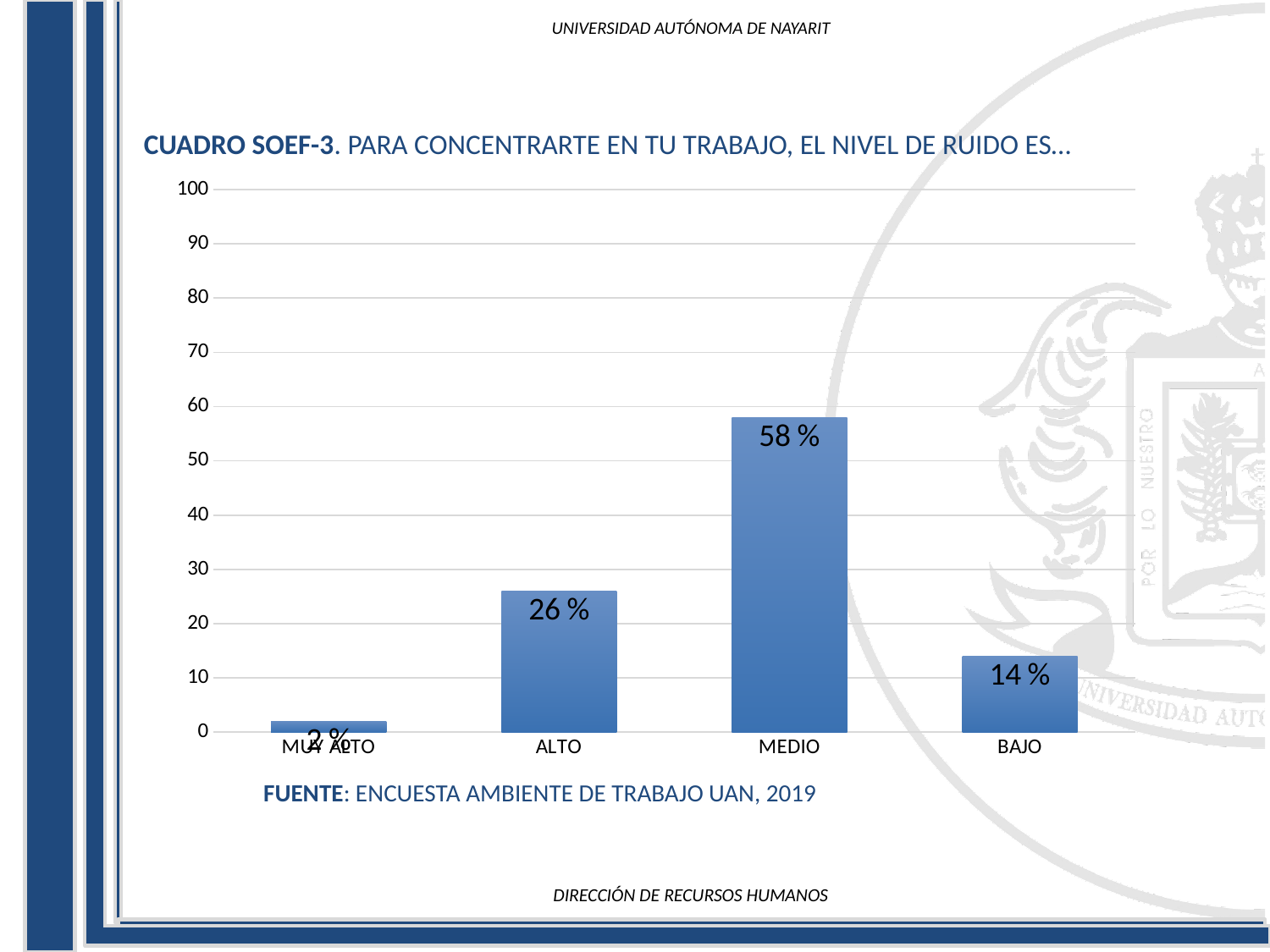
What kind of chart is shown on the slide? bar chart What is the difference between the values for ALTO and BAJO? 12 % What source is cited below the chart? ENCUESTA AMBIENTE DE TRABAJO UAN, 2019 What is the value for MEDIO? 58 % Which category has the highest value? MEDIO Which is larger, the value for ALTO or the value for BAJO? ALTO How many categories are shown on the x axis? 4 What is the difference between the values for MEDIO and ALTO? 32 % Is the value for MEDIO greater or less than 50? greater What is the value for BAJO? 14 % Which category has the lowest value? MUY ALTO What is the value for ALTO? 26 %